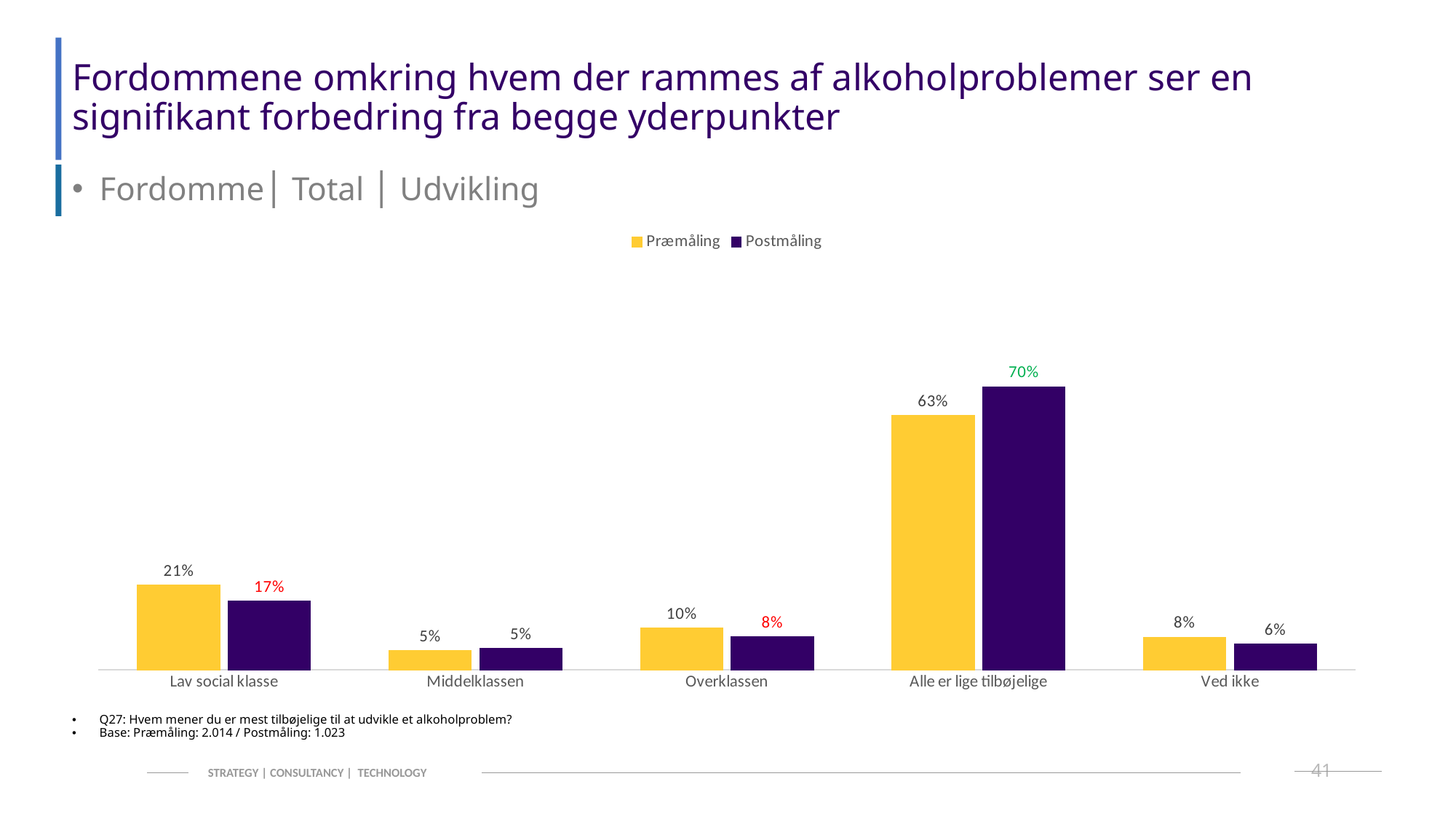
Which category has the lowest Præmåling value? Middelklassen What is the Postmåling value for Alle er lige tilbøjelige? 70% What is the difference between the Postmåling and Præmåling values for Alle er lige tilbøjelige? 7% What kind of chart is shown on the slide? Bar chart How many categories are shown on the x axis? 5 Which is larger for Overklassen, the Præmåling value or the Postmåling value? Præmåling How many series does the legend list? 2 What is the Præmåling value for Lav social klasse? 21% Which category has the highest Postmåling value? Alle er lige tilbøjelige What is the Postmåling value for Overklassen? 8% What is the difference between the Præmåling and Postmåling values for Lav social klasse? 4% What is the Præmåling value for Ved ikke? 8%